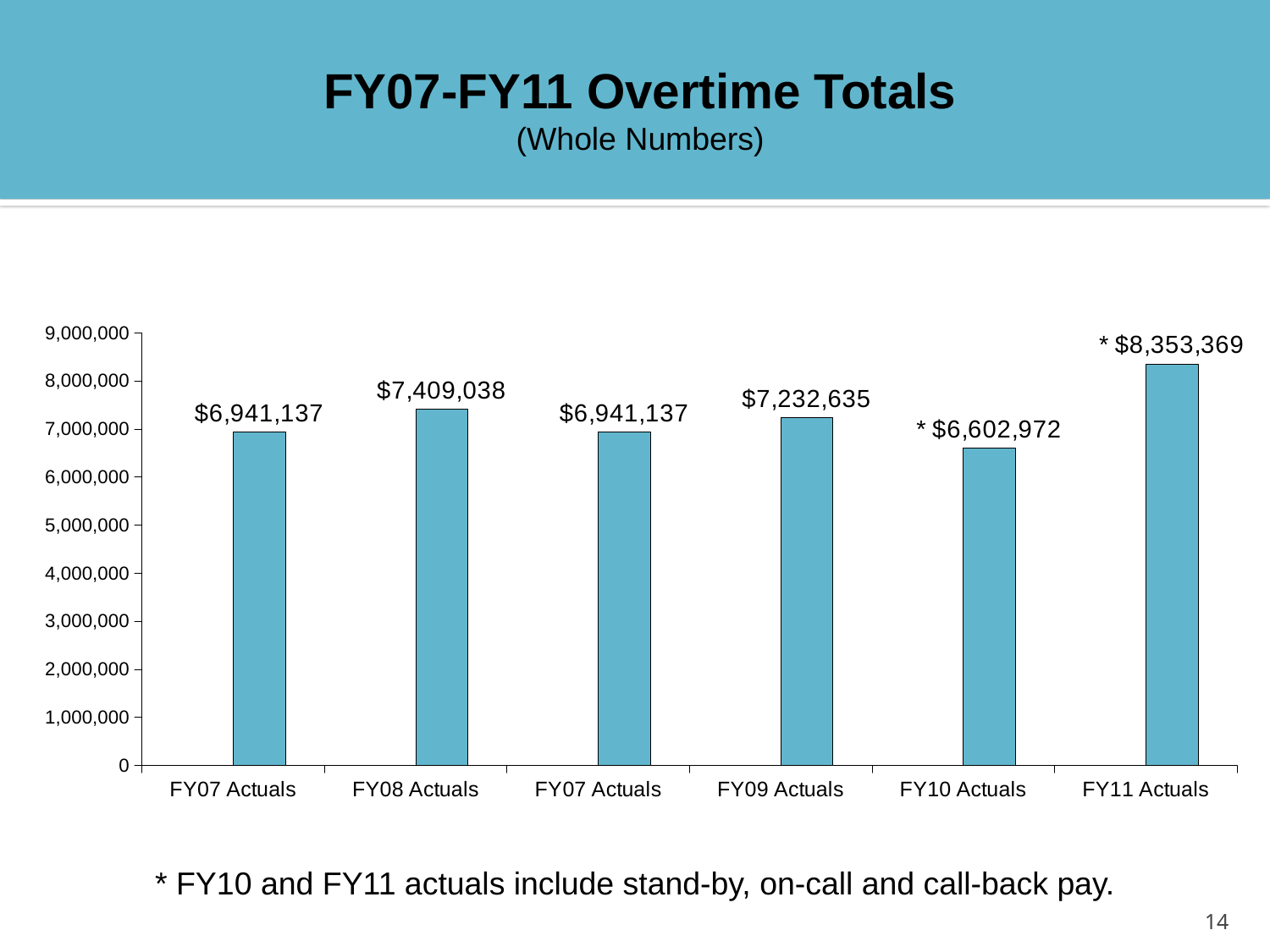
What is the difference between the values for FY11 Actuals and FY10 Actuals? $1,750,397 What kind of chart is shown on the slide? bar chart How many bars are shown in the chart? 6 Is the value for FY11 Actuals greater or less than 8,000,000? greater Which category has the lowest value? FY10 Actuals Which category has the highest value? FY11 Actuals What is the value for FY09 Actuals? $7,232,635 What is the value for FY11 Actuals? $8,353,369 What is the value for FY10 Actuals? $6,602,972 What is the difference between the values for FY08 Actuals and FY09 Actuals? $176,403 Which is larger, the value for FY08 Actuals or FY09 Actuals? FY08 Actuals What is the value for FY08 Actuals? $7,409,038